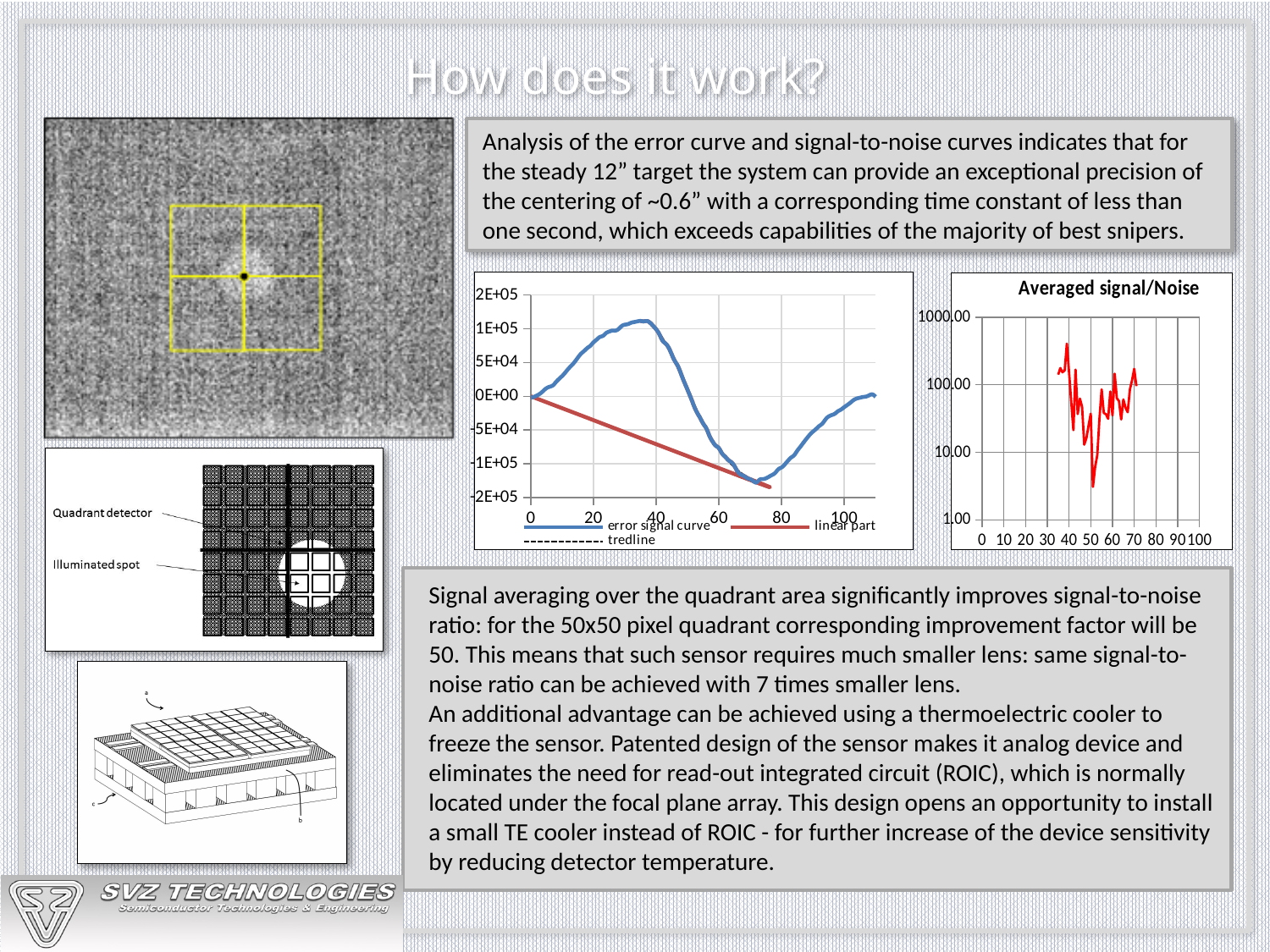
In the left chart, does the linear part rise or fall as x increases? fall In the left chart, does the error signal curve rise or fall between x = 40 and x = 70? fall What kind of chart is the left chart (with the error signal curve)? line chart In the left chart, is the value of the linear part at x = 70 greater or less than -1E+05? less In the left chart, is the value of the error signal curve at x = 40 greater or less than 5E+04? greater In the "Averaged signal/Noise" chart, is the lowest value of the curve greater or less than 10.00? less What is the title of the right chart? Averaged signal/Noise What is the highest tick value shown on the y axis of the "Averaged signal/Noise" chart? 1000.00 What kind of chart is the chart titled "Averaged signal/Noise"? line chart What are the legend entries of the left chart? error signal curve, linear part, tredline How many series does the legend of the left chart list? 3